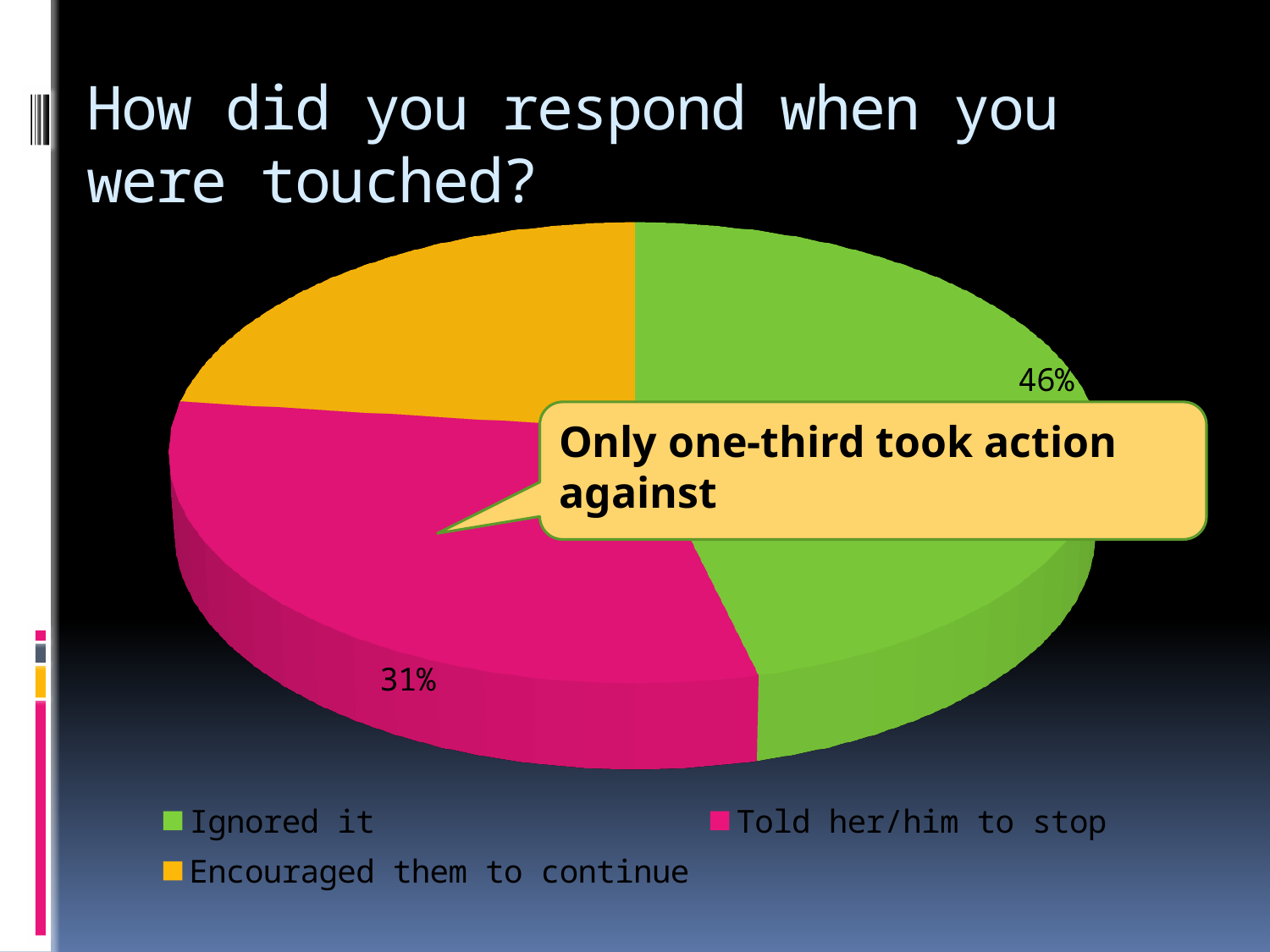
What percentage of respondents said they ignored it? 46% What share of the pie does the 'Told her/him to stop' slice represent? 31% Which response has the largest share of the pie? Ignored it How many categories does the pie chart show? 3 What is the title of the chart? How did you respond when you were touched? What kind of chart is shown on the slide? pie chart What percentage of respondents told her/him to stop? 31% What is the difference in percentage points between 'Ignored it' and 'Told her/him to stop'? 15 percentage points Which colour represents 'Encouraged them to continue' in the legend? orange Which is larger: the share for 'Ignored it' or the share for 'Told her/him to stop'? Ignored it Which response has the smallest share of the pie? Encouraged them to continue